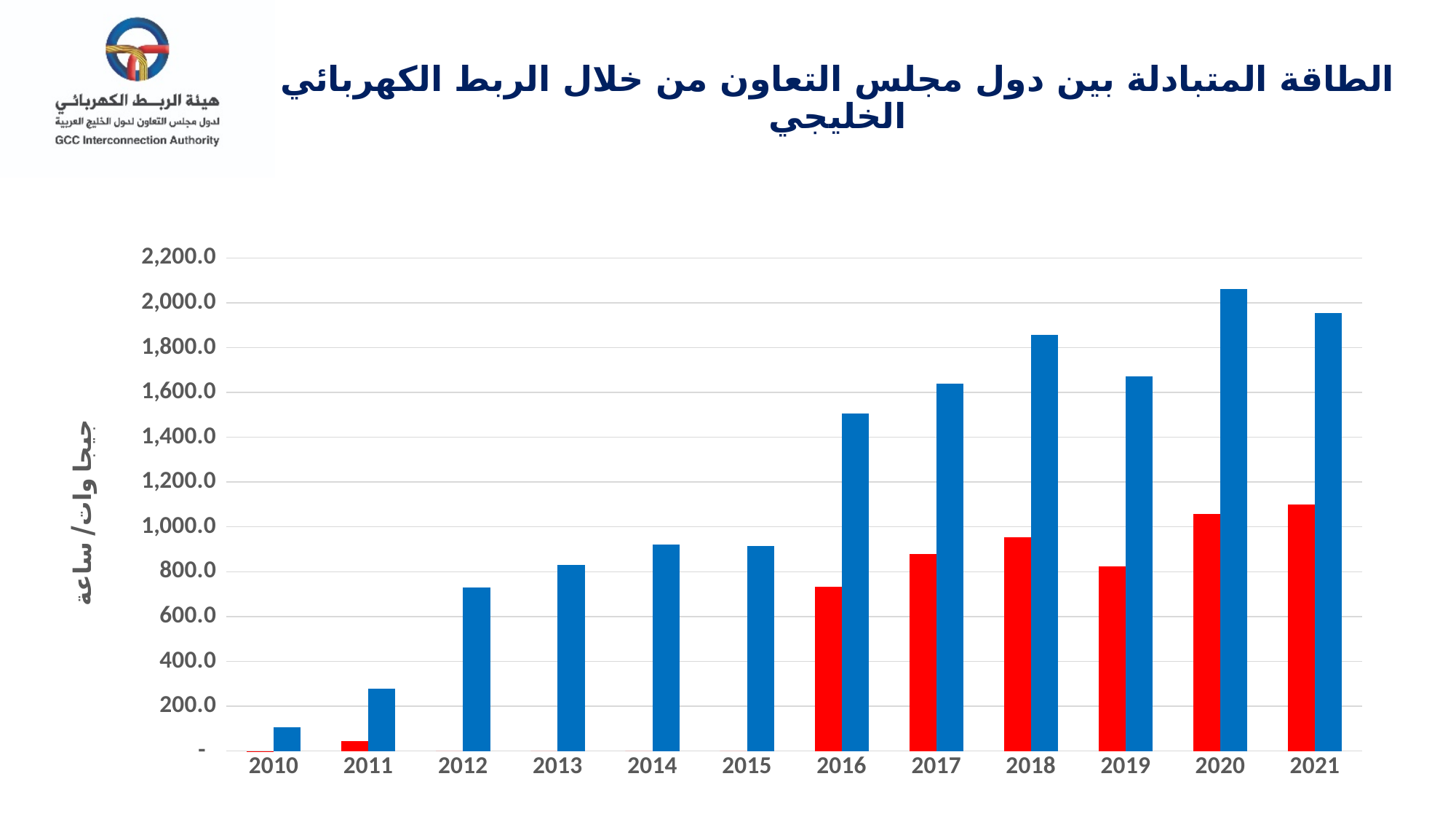
How many years are shown on the x axis of the chart? 12 Is the value of the blue bar for 2012 greater or less than 800.0? less Which year has the larger red bar, 2016 or 2021? 2021 Which year has the larger blue bar, 2018 or 2019? 2018 What is the label on the vertical axis of the chart? جيجا وات/ ساعة Do the blue bars rise or fall from 2010 to 2014? rise In which year is the red bar the highest? 2021 In which year is the blue bar the highest? 2020 Is the value of the blue bar for 2020 greater or less than 2,000.0? greater Is the value of the red bar for 2021 greater or less than 1,000.0? greater In which year is the blue bar the lowest? 2010 What kind of chart is shown on the slide? bar chart